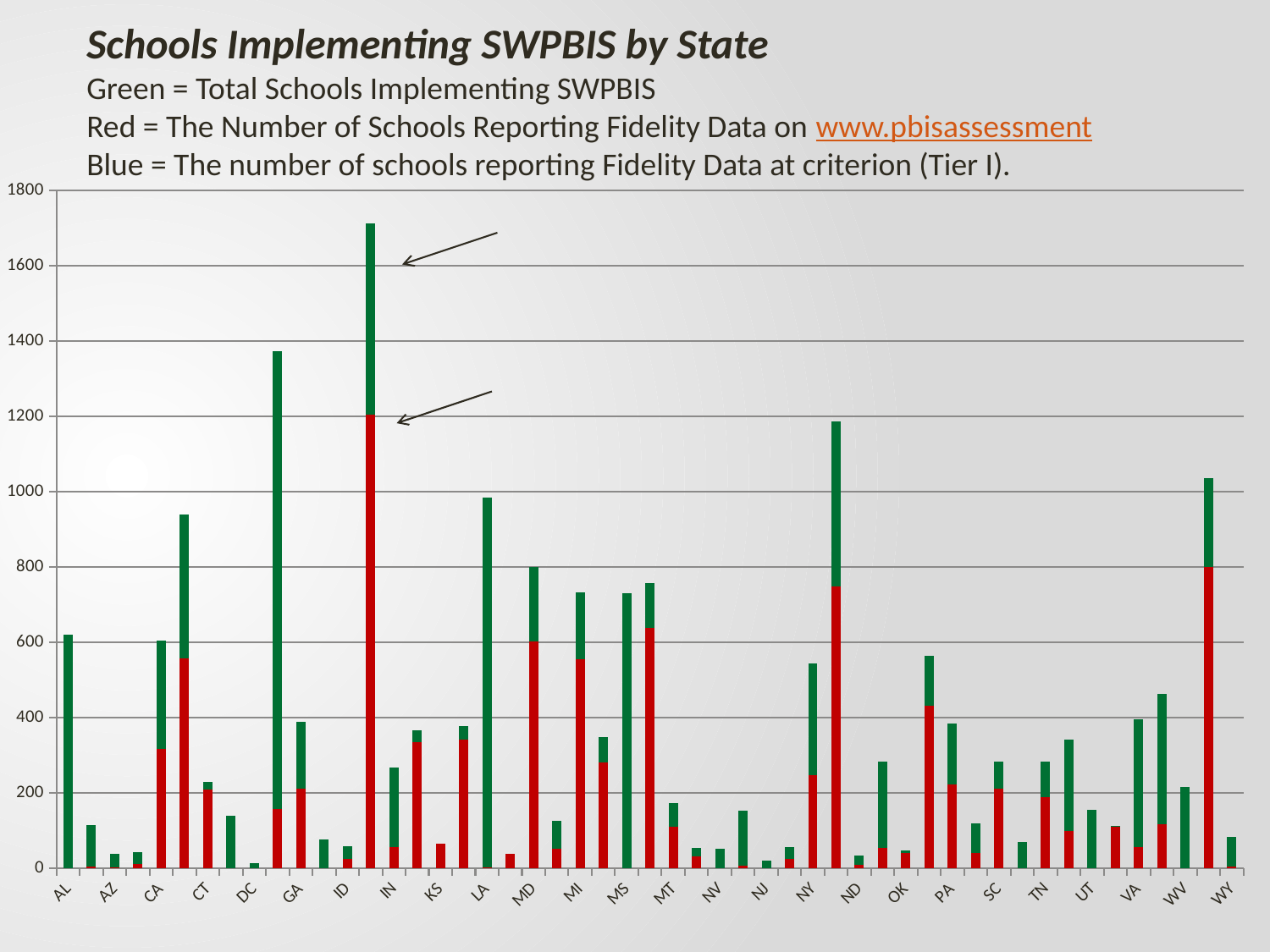
What kind of chart is shown on the slide? bar chart According to the slide, what do the green bars represent? Total Schools Implementing SWPBIS Is the green value for NY greater or less than 400? less Is the green value for WY greater or less than 200? less Is the green value for NJ greater or less than 200? less What is the title of the chart? Schools Implementing SWPBIS by State Which has the taller green bar, AL or AZ? AL Which has the taller green bar, LA or MD? LA